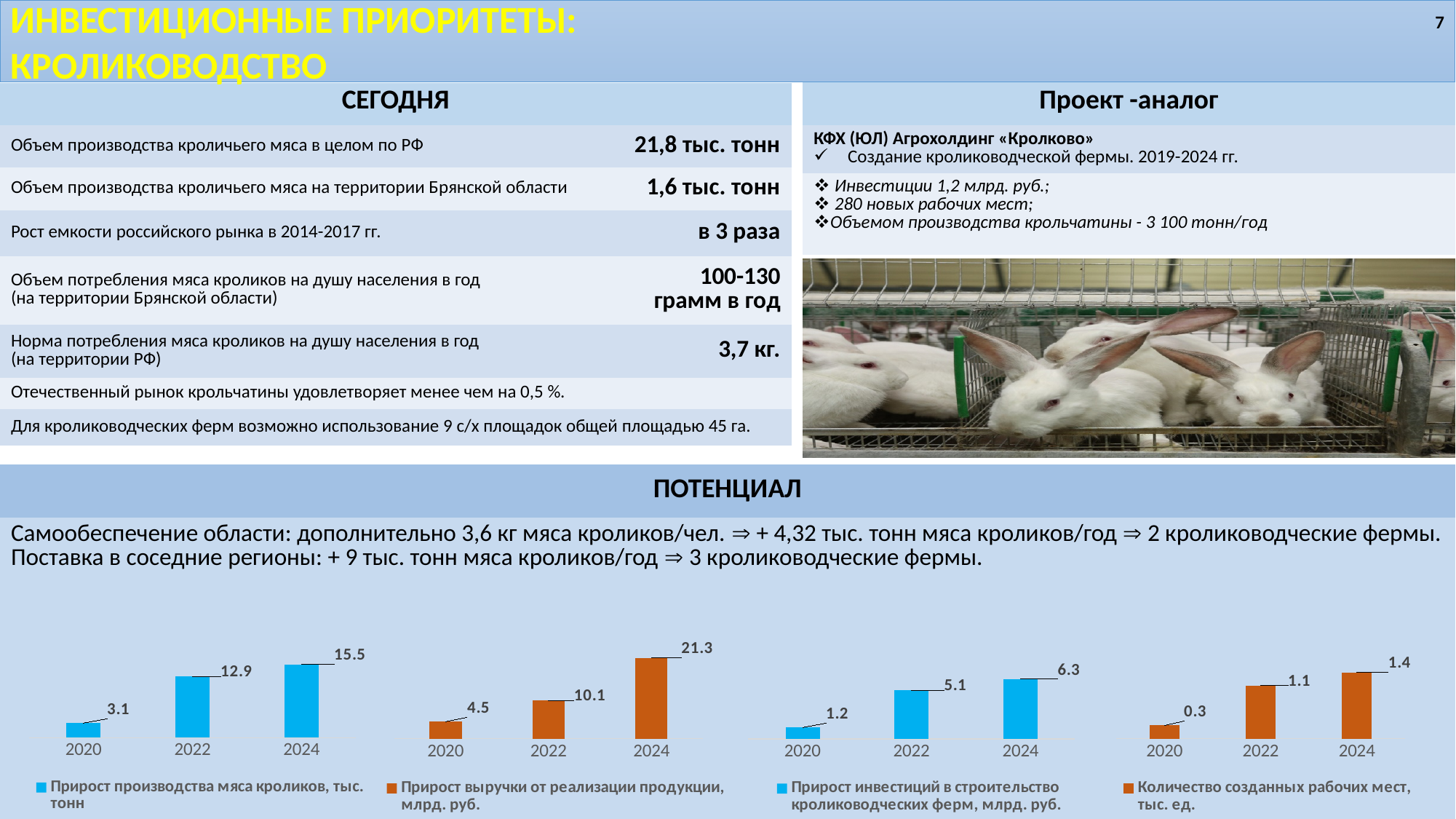
In the rightmost chart (Количество созданных рабочих мест, тыс. ед.), what is the value for 2022? 1.1 In the chart 'Прирост инвестиций в строительство кролиководческих ферм, млрд. руб.', what is the difference between the 2024 and 2022 values? 1.2 In the leftmost chart (Прирост производства мяса кроликов, тыс. тонн), which year has the lowest value? 2020 In the leftmost chart (Прирост производства мяса кроликов, тыс. тонн), what is the difference between the 2024 and 2020 values? 12.4 In the chart 'Прирост выручки от реализации продукции, млрд. руб.', what is the value for 2022? 10.1 In the chart 'Прирост инвестиций в строительство кролиководческих ферм, млрд. руб.', do the values rise or fall from 2020 to 2024? Rise In the chart 'Прирост выручки от реализации продукции, млрд. руб.', which year has the highest value? 2024 In the rightmost chart (Количество созданных рабочих мест, тыс. ед.), which is larger: the value for 2022 or for 2024? 2024 In the chart 'Прирост инвестиций в строительство кролиководческих ферм, млрд. руб.', what is the value for 2020? 1.2 How many years (categories) are shown in the chart 'Прирост выручки от реализации продукции, млрд. руб.'? 3 What type of chart is the leftmost chart (Прирост производства мяса кроликов, тыс. тонн)? Bar chart In the leftmost chart (Прирост производства мяса кроликов, тыс. тонн), what is the value for 2024? 15.5